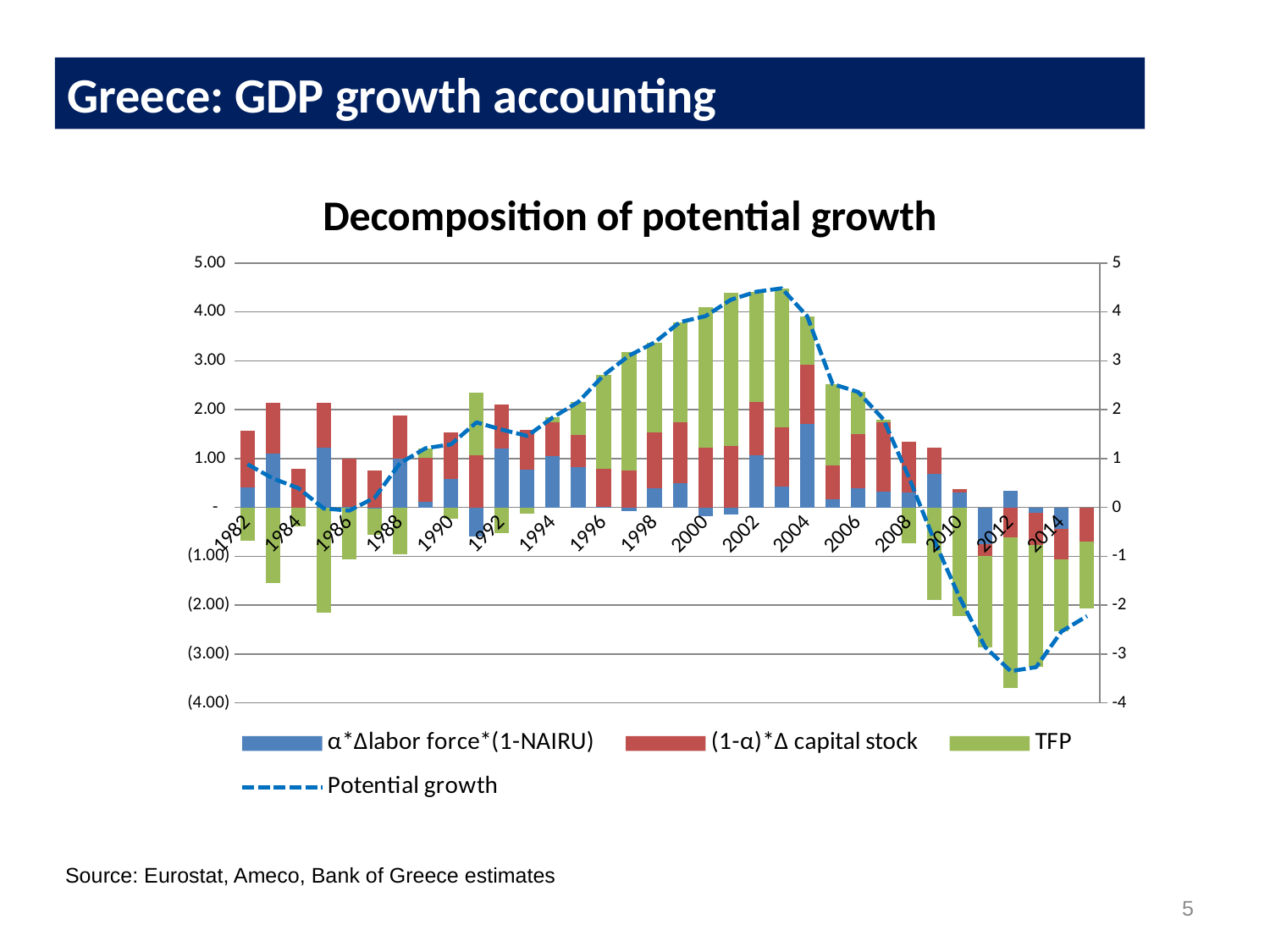
Is the value of Potential growth in 1990 greater or less than 2? less Which is larger, Potential growth in 2002 or in 2012? 2002 Is the value of Potential growth in 2002 greater or less than 4? greater Is the value of Potential growth in 2010 greater or less than -1? less Does Potential growth rise or fall between 2004 and 2012? fall What kind of chart is shown on the slide? Stacked bar chart with a line overlay Does Potential growth rise or fall between 1994 and 2002? rise How many series does the legend list? 4 What is the title of the chart? Decomposition of potential growth Which series is drawn as a dashed line rather than bars? Potential growth